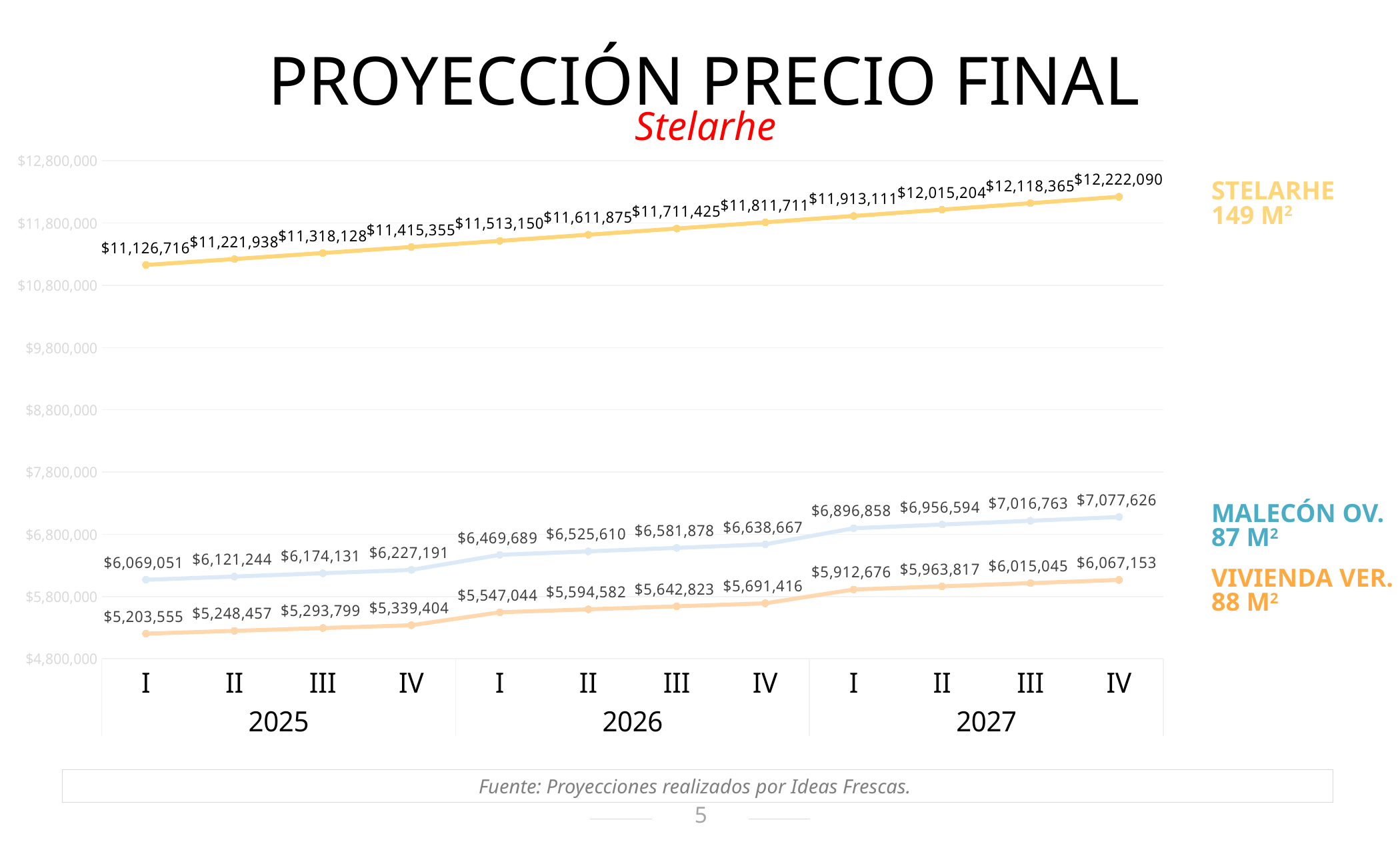
What type of chart is shown on the slide? line chart Which series has the highest projected prices throughout the chart? STELARHE 149 M² What is the projected price for MALECÓN OV. 87 M² in quarter I of 2026? $6,469,689 By how much does the STELARHE 149 M² price increase from quarter I of 2025 to quarter IV of 2027? $1,095,374 How many quarterly data points does each line have? 12 Which series has the lowest projected prices throughout the chart? VIVIENDA VER. 88 M² What is the projected price for STELARHE 149 M² in quarter I of 2025? $11,126,716 How many series does the chart show? 3 What is the difference between MALECÓN OV. 87 M² and VIVIENDA VER. 88 M² in quarter IV of 2027? $1,010,473 What is the projected price for VIVIENDA VER. 88 M² in quarter III of 2027? $6,015,045 Do the projected prices rise or fall over time along the x axis? rise What is the projected price for STELARHE 149 M² in quarter IV of 2027? $12,222,090